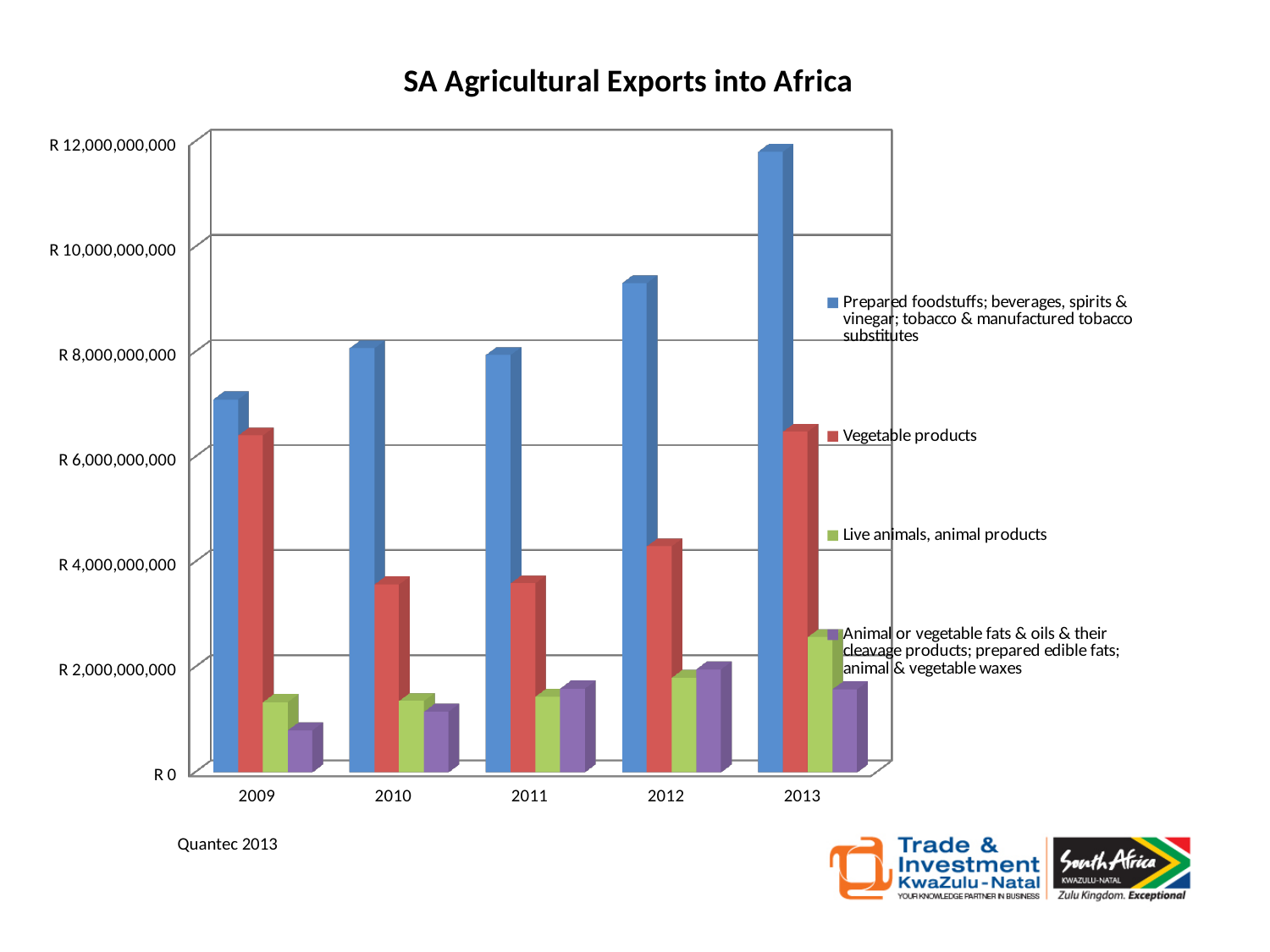
What kind of chart is shown on the slide? Bar chart In which year is the value for Prepared foodstuffs; beverages, spirits & vinegar; tobacco & manufactured tobacco substitutes lowest? 2009 Is the value for Vegetable products in 2010 greater or less than R 4,000,000,000? less Is the value for Prepared foodstuffs in 2013 greater or less than R 10,000,000,000? greater How many series does the legend list? 4 Is the value for Live animals, animal products in 2013 greater or less than R 2,000,000,000? greater In which year is the value for Prepared foodstuffs; beverages, spirits & vinegar; tobacco & manufactured tobacco substitutes highest? 2013 How many years are shown on the x axis? 5 Which series has the lowest value in 2009? Animal or vegetable fats & oils & their cleavage products; prepared edible fats; animal & vegetable waxes Which is larger for Prepared foodstuffs: the value in 2011 or the value in 2012? 2012 Which series has the highest value in 2013? Prepared foodstuffs; beverages, spirits & vinegar; tobacco & manufactured tobacco substitutes What is the title of the chart? SA Agricultural Exports into Africa